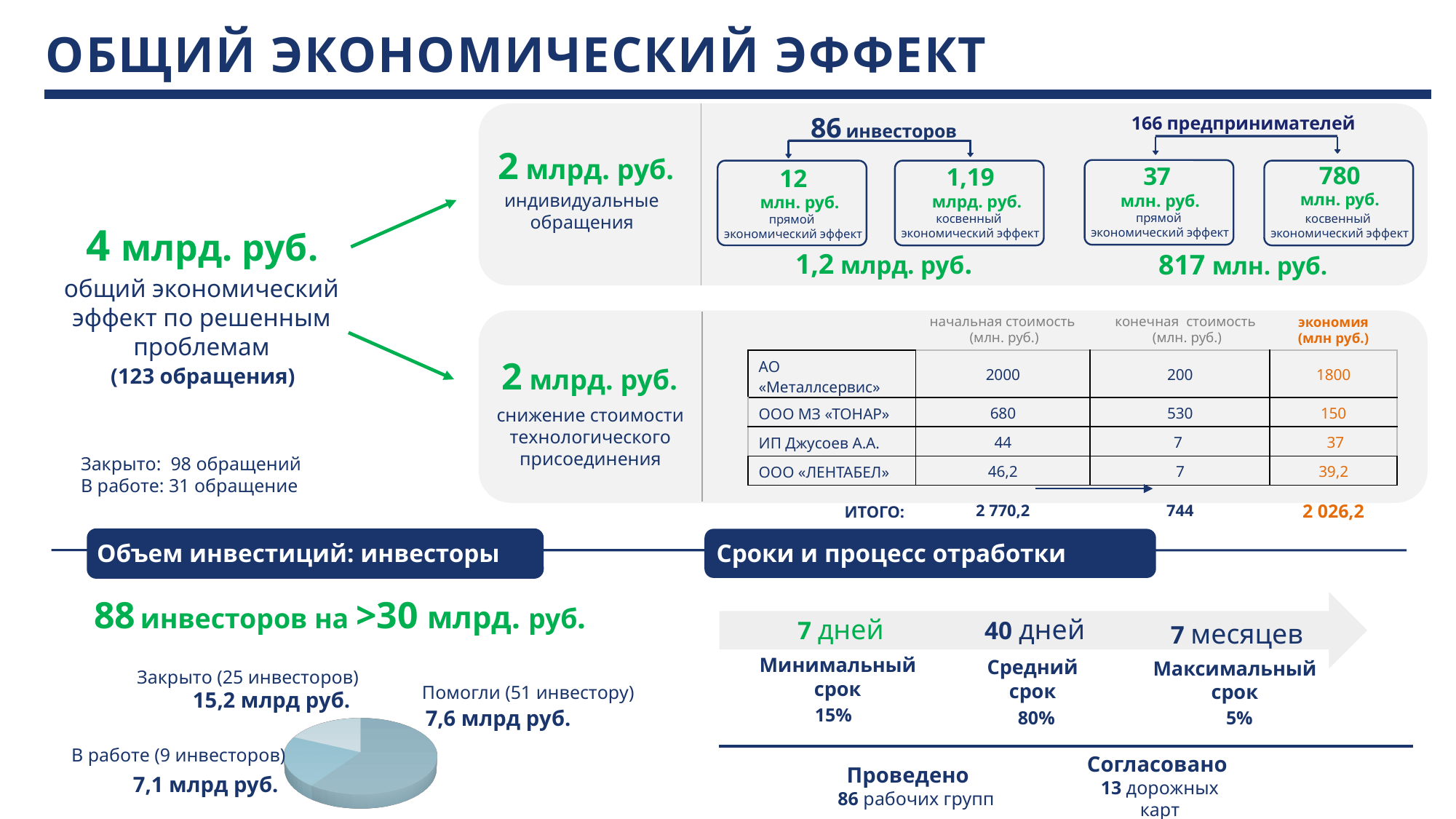
What value is shown for the "Закрыто (25 инвесторов)" slice of the pie chart? 15,2 млрд руб. What value is shown for the "В работе (9 инвесторов)" slice of the pie chart? 7,1 млрд руб. Which slice of the pie chart has the smallest value? В работе (9 инвесторов) What kind of chart is shown in the bottom-left section of the slide? pie chart What is the difference between the "Помогли" value and the "В работе" value in the pie chart? 0,5 млрд руб. What is the difference between the "Закрыто" value and the "Помогли" value in the pie chart? 7,6 млрд руб. How many slices does the pie chart have? 3 Under which section heading does the pie chart appear? Объем инвестиций: инвесторы How many investors are listed for the "Помогли" slice of the pie chart? 51 In the pie chart, which is larger: the value for "Закрыто" or the value for "Помогли"? Закрыто Which slice of the pie chart has the largest value? Закрыто (25 инвесторов) What value is shown for the "Помогли (51 инвестору)" slice of the pie chart? 7,6 млрд руб.